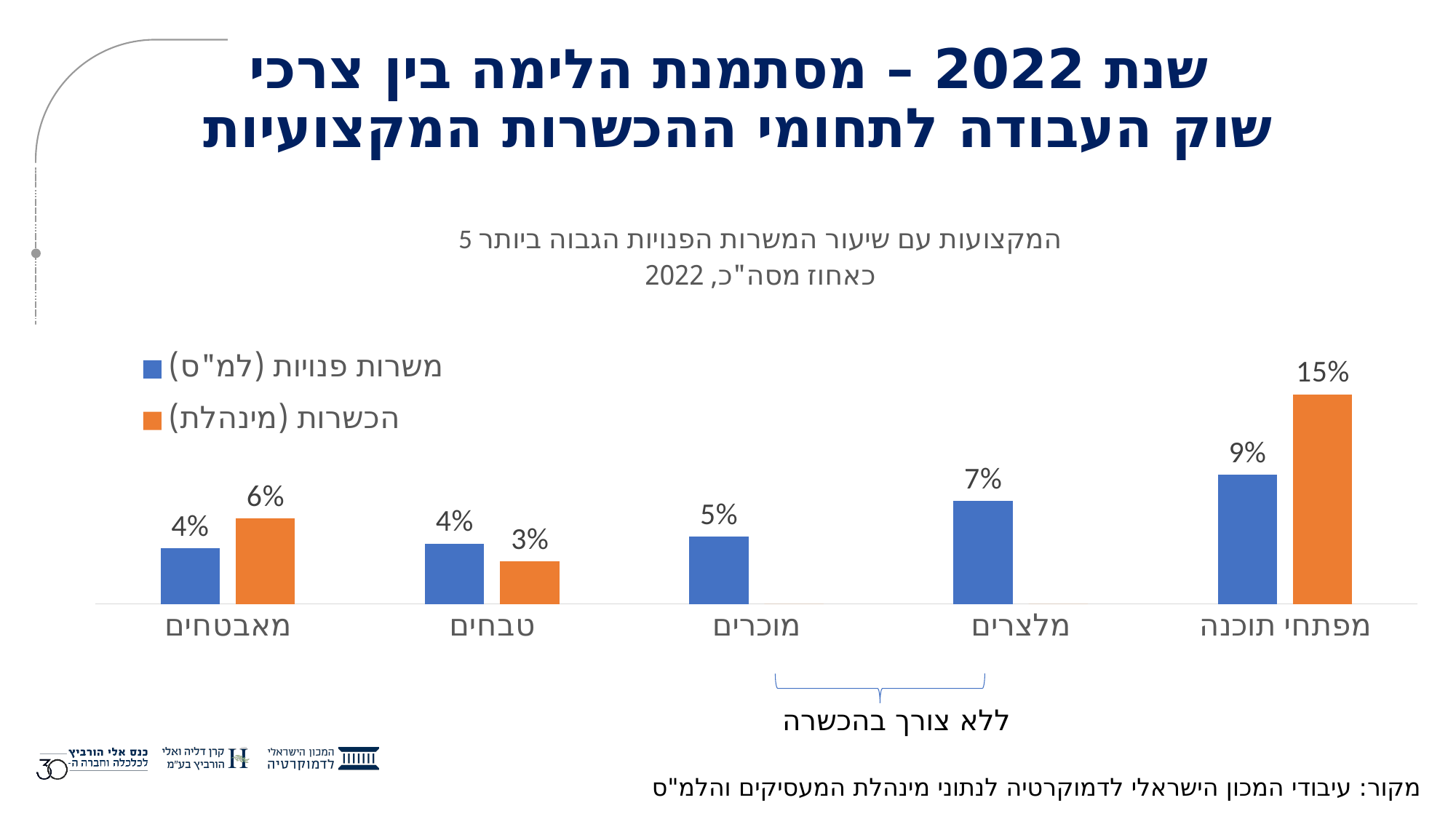
What is the difference between הכשרות (מינהלת) and משרות פנויות (למ"ס) for מפתחי תוכנה? 6% How many categories are shown on the x axis? 5 Which category has the highest value for משרות פנויות (למ"ס)? מפתחי תוכנה What is the value of משרות פנויות (למ"ס) for מפתחי תוכנה? 9% Which categories have no bar for הכשרות (מינהלת)? מוכרים and מלצרים What kind of chart is shown on the slide? Bar chart What is the value of הכשרות (מינהלת) for מאבטחים? 6% What is the value of הכשרות (מינהלת) for מפתחי תוכנה? 15% Which is larger for טבחים: משרות פנויות (למ"ס) or הכשרות (מינהלת)? משרות פנויות (למ"ס) What is the value of משרות פנויות (למ"ס) for מלצרים? 7% How many series does the legend list? 2 Which category has the lowest value for הכשרות (מינהלת) among those with a bar for that series? טבחים